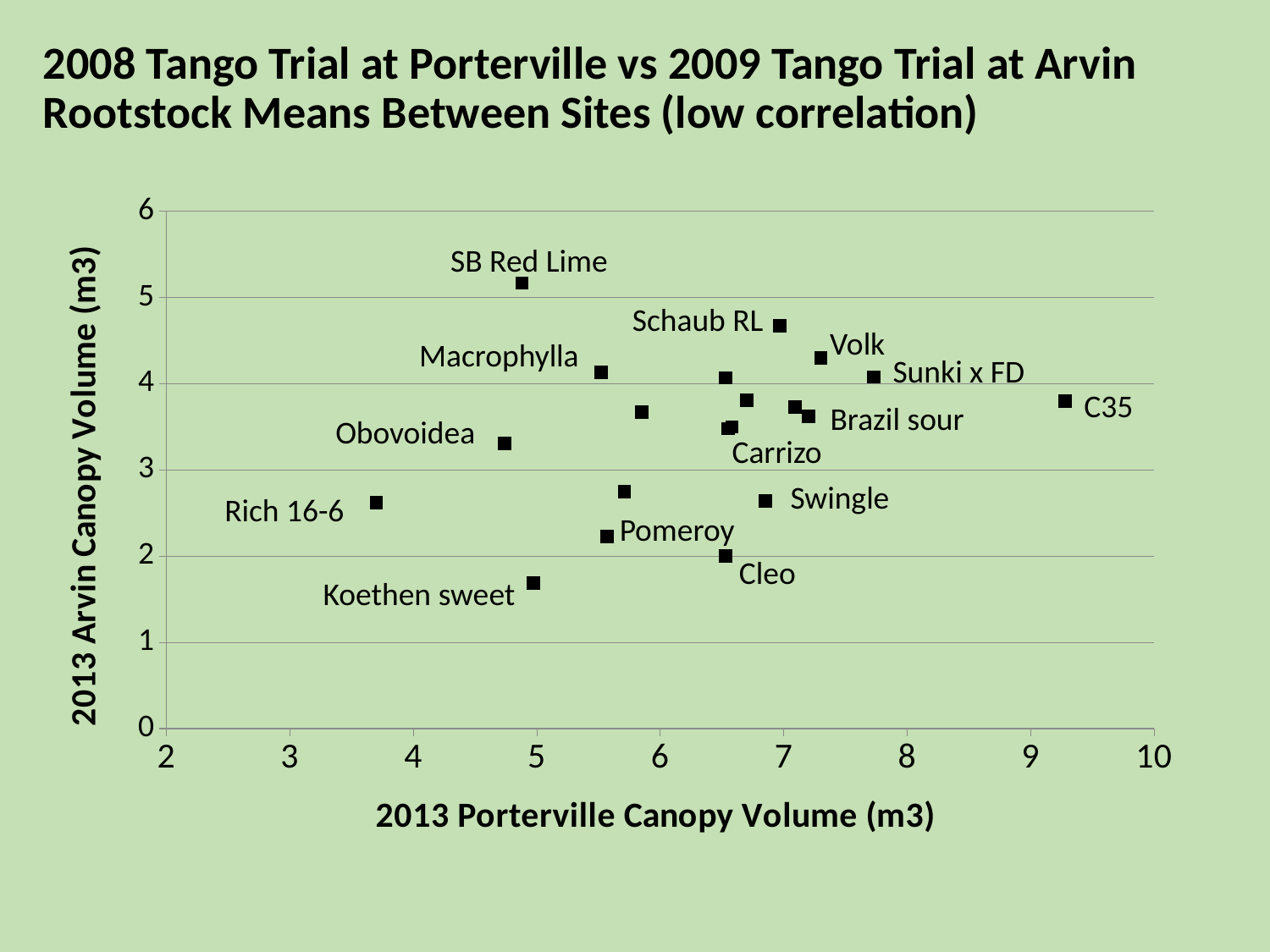
How many points on the chart have a rootstock name label? 14 Which labeled rootstock has the highest 2013 Arvin Canopy Volume? SB Red Lime Is the 2013 Porterville Canopy Volume for C35 greater or less than 9? greater What is the title of the x axis? 2013 Porterville Canopy Volume (m3) Which has the higher 2013 Arvin Canopy Volume, Schaub RL or Volk? Schaub RL Which labeled rootstock has the lowest 2013 Arvin Canopy Volume? Koethen sweet Is the 2013 Porterville Canopy Volume for Rich 16-6 greater or less than 4? less Is the 2013 Arvin Canopy Volume for Koethen sweet greater or less than 2? less Which labeled rootstock has the lowest 2013 Porterville Canopy Volume? Rich 16-6 Which labeled rootstock has the highest 2013 Porterville Canopy Volume? C35 What kind of chart is shown on the slide? Scatter chart